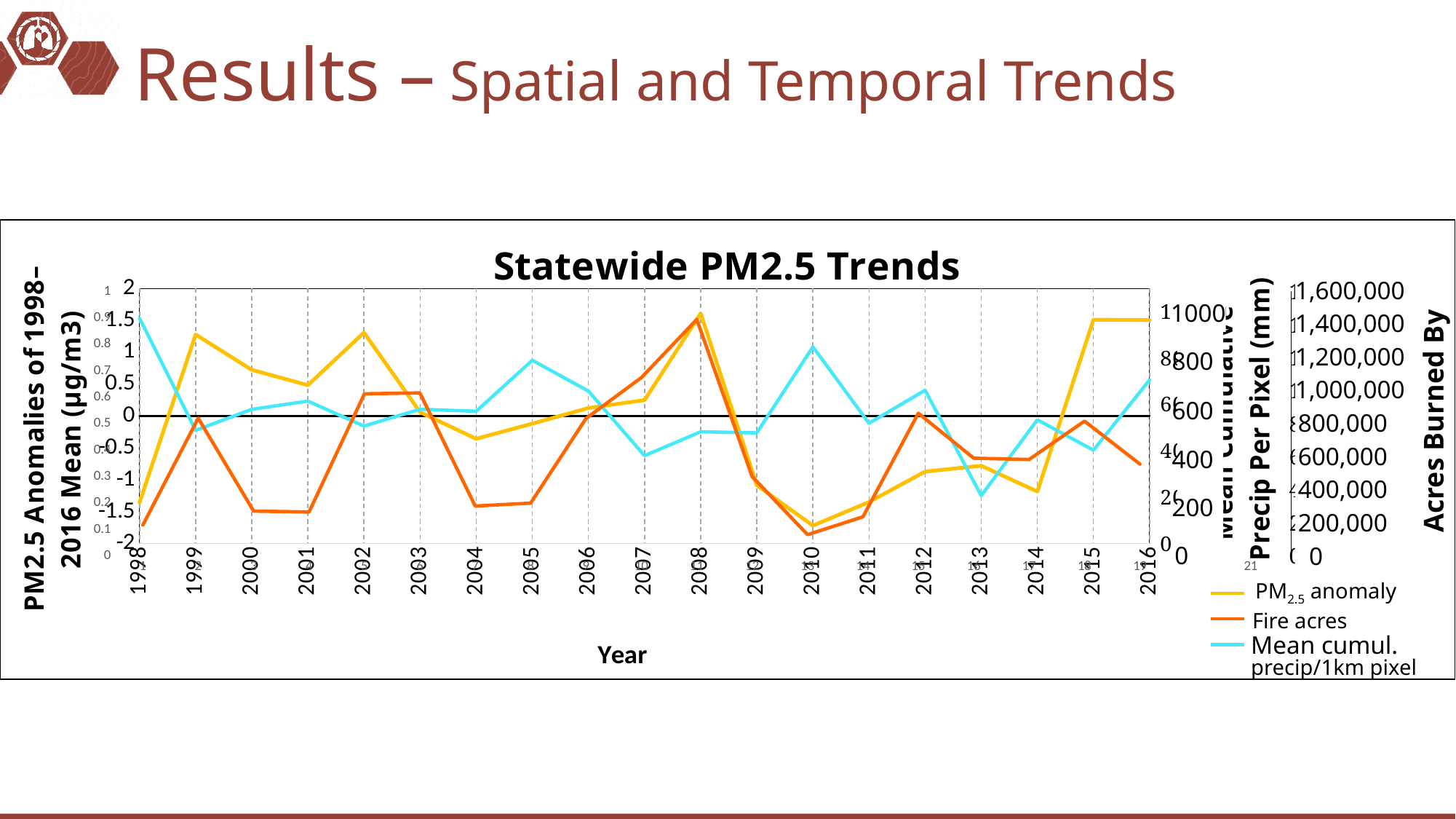
In which year is the PM2.5 anomaly series at its lowest? 2010 Which year has the higher PM2.5 anomaly, 1999 or 2000? 1999 Is the PM2.5 anomaly value for 2008 greater or less than 1? greater In which year is the Mean cumul. precip/1km pixel series at its highest? 1998 How many years are plotted along the x axis? 19 What kind of chart is shown on the slide? Line chart What is the title of the chart? Statewide PM2.5 Trends Which series is drawn in orange? Fire acres How many series does the legend list? 3 Is the PM2.5 anomaly value for 2010 greater or less than -1? less In which year is the Fire acres series at its highest? 2008 In which year is the Mean cumul. precip/1km pixel series at its lowest? 2013